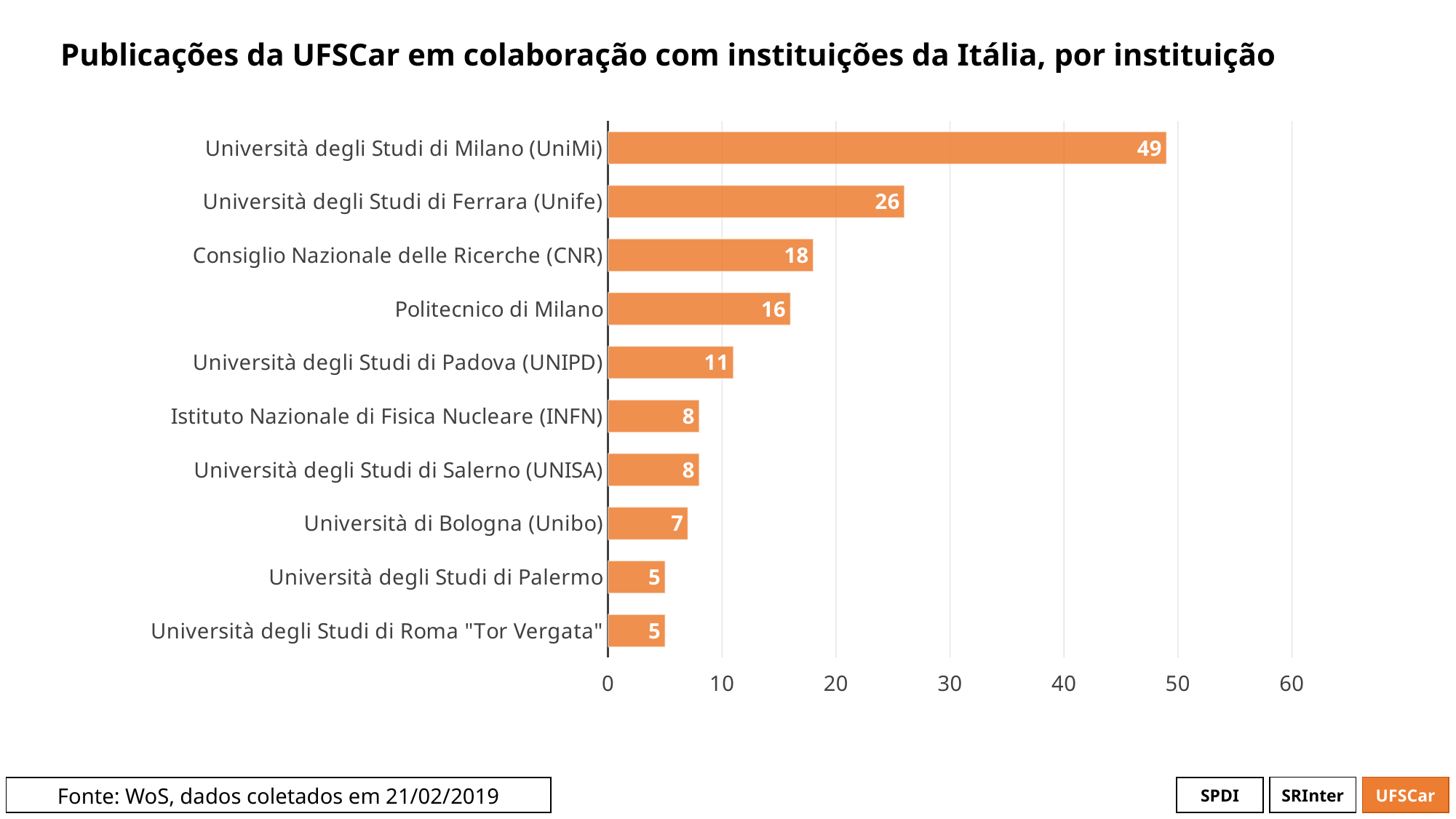
Which institution has the highest number of publications in collaboration with UFSCar? Università degli Studi di Milano (UniMi) How many publications does the chart show for Università degli Studi di Milano (UniMi)? 49 What is the title of the chart? Publicações da UFSCar em colaboração com instituições da Itália, por instituição What is the data source stated on the slide? WoS, dados coletados em 21/02/2019 What is the value for Consiglio Nazionale delle Ricerche (CNR)? 18 How many institutions are shown in the chart? 10 Is the value for Università degli Studi di Milano (UniMi) greater or less than 40? greater What kind of chart is shown on the slide? bar chart What is the difference between the values for Politecnico di Milano and Università di Bologna (Unibo)? 9 What is the difference between the values for Università degli Studi di Milano (UniMi) and Università degli Studi di Ferrara (Unife)? 23 Which is larger, the value for Università degli Studi di Ferrara (Unife) or the value for Consiglio Nazionale delle Ricerche (CNR)? Università degli Studi di Ferrara (Unife) What is the value for Università degli Studi di Padova (UNIPD)? 11